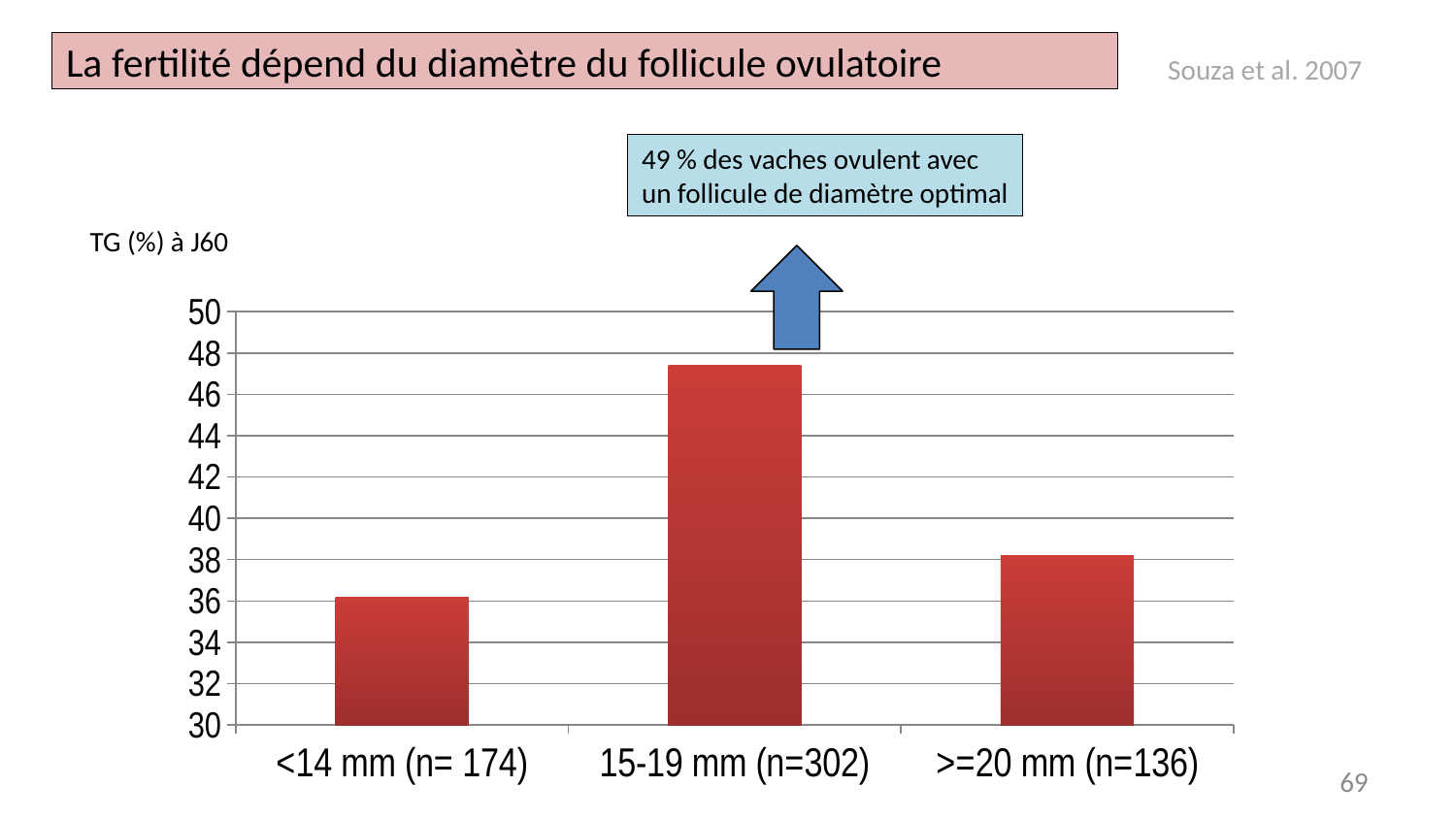
What kind of chart is shown on the slide? bar chart Which is larger, the value for <14 mm (n= 174) or the value for >=20 mm (n=136)? >=20 mm (n=136) Is the value for 15-19 mm (n=302) greater or less than 48? less What is the label of the y axis of the chart? TG (%) à J60 Which category has the lowest value in the chart? <14 mm (n= 174) Is the value for 15-19 mm (n=302) greater or less than 46? greater Which category has the highest value in the chart? 15-19 mm (n=302) Is the value for <14 mm (n= 174) greater or less than 38? less What is the title shown above the chart on the slide? La fertilité dépend du diamètre du follicule ovulatoire Which is larger, the value for 15-19 mm (n=302) or the value for >=20 mm (n=136)? 15-19 mm (n=302) How many categories are shown on the x axis of the chart? 3